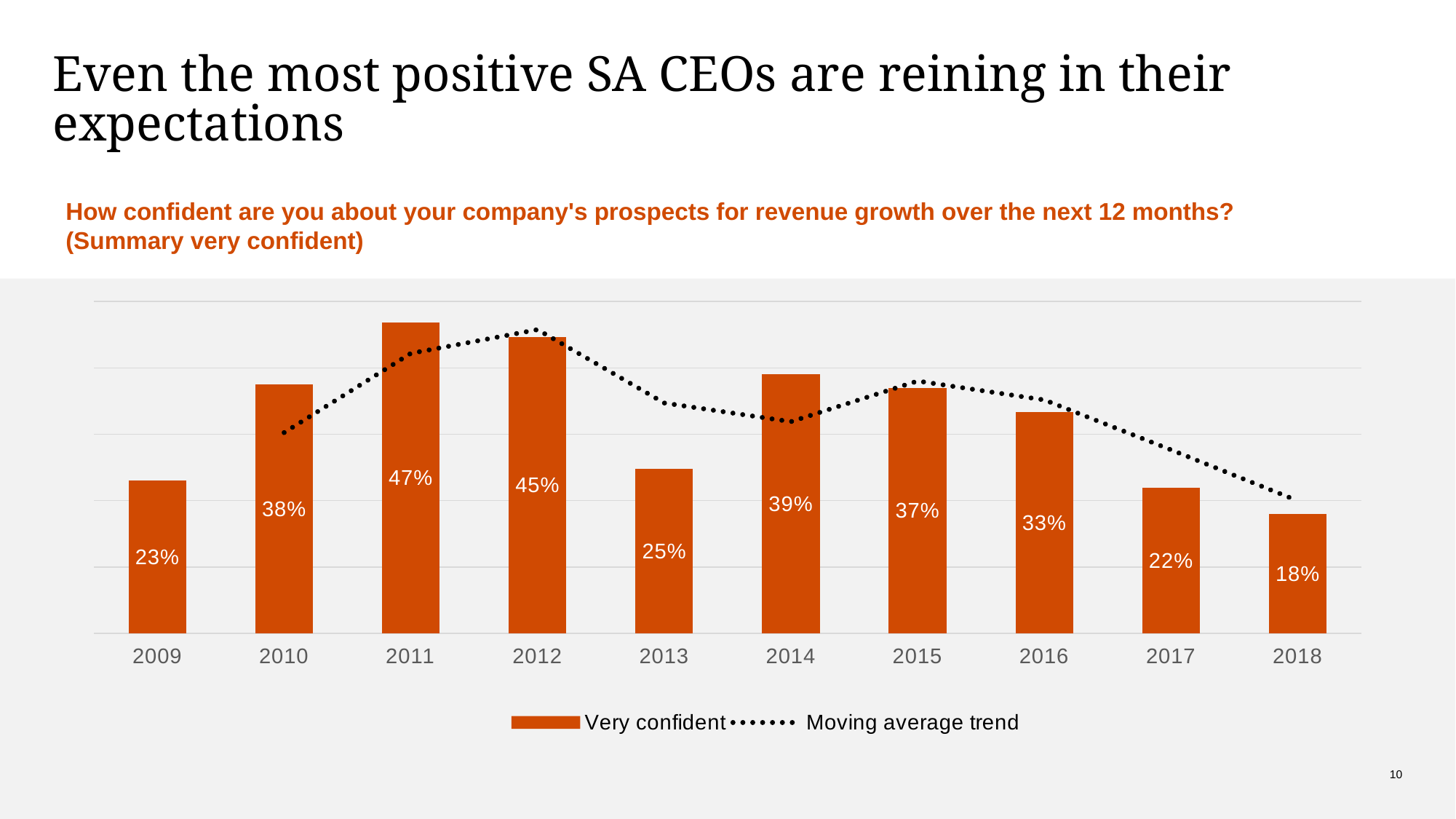
What is the value for 2018? 18% What kind of chart is shown on the slide? Bar chart with a dotted moving average trend line Which year has the lowest share of very confident CEOs? 2018 What percentage of SA CEOs were very confident in 2011? 47% Do the values rise or fall from 2014 to 2018? Fall Which year has the highest share of very confident CEOs? 2011 What is the difference between the values for 2014 and 2013? 14% How many years are shown on the x axis? 10 How many series does the legend list? 2 Which is larger, the value for 2010 or the value for 2015? 2010 What is the value for 2013? 25% What is the difference between the values for 2011 and 2018? 29%